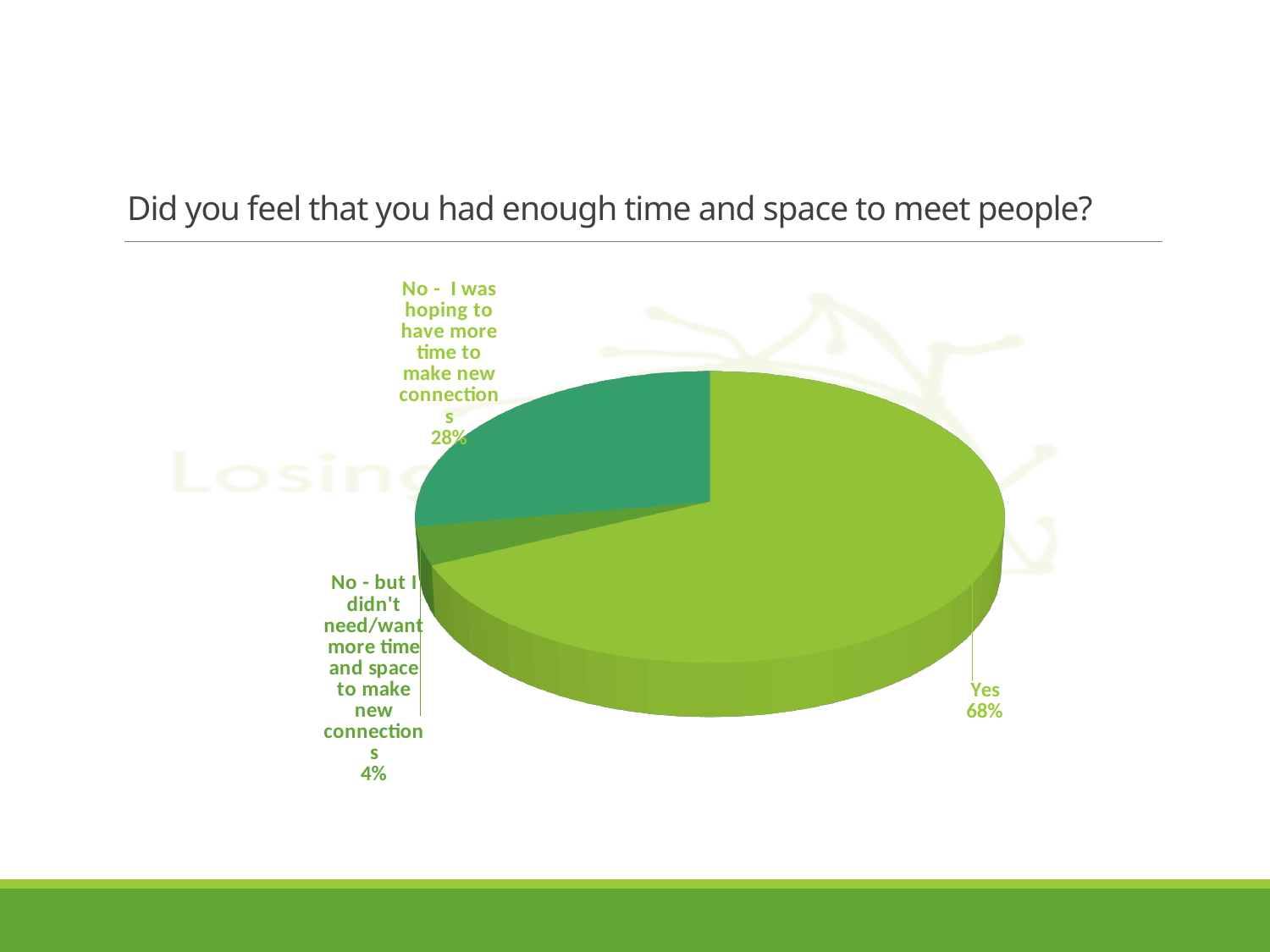
How many slices does the pie chart have? 3 What is the combined share of the two "No" responses? 32% What share of respondents answered "No - but I didn't need/want more time and space to make new connections"? 4% What share of respondents answered "Yes"? 68% Is the share for "Yes" greater or less than 50%? greater What kind of chart is shown on the slide? Pie chart What is the difference in percentage points between the "Yes" share and the "No - I was hoping to have more time to make new connections" share? 40 percentage points Which is larger: the share for "Yes" or the share for "No - I was hoping to have more time to make new connections"? Yes What share of respondents answered "No - I was hoping to have more time to make new connections"? 28% What question does the chart title ask? Did you feel that you had enough time and space to meet people? Which response has the smallest share of the pie? No - but I didn't need/want more time and space to make new connections Which response has the largest share of the pie? Yes